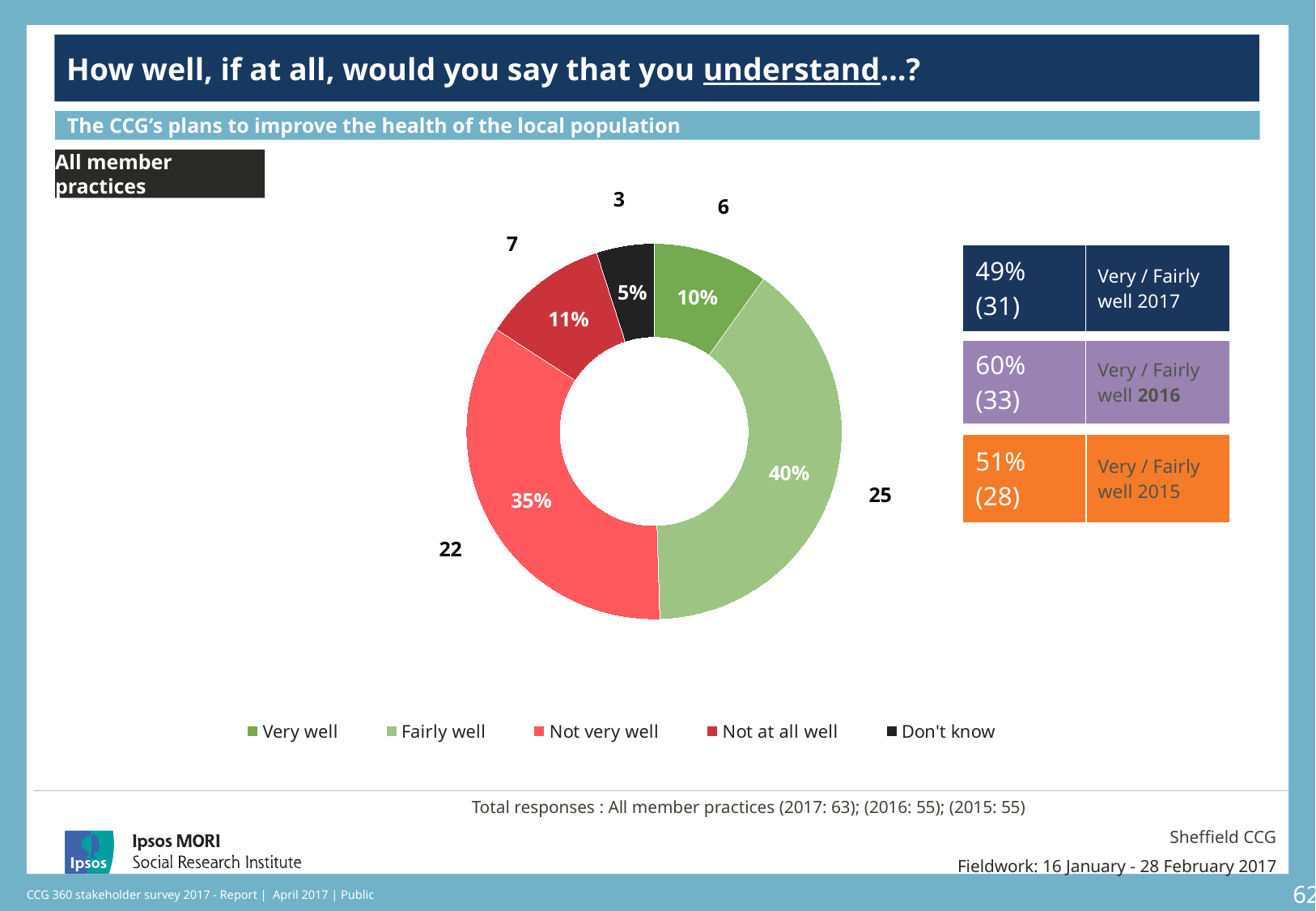
What percentage of respondents answered 'Very well'? 10% What is the difference in percentage points between 'Fairly well' and 'Not very well'? 5 percentage points How many response categories does the legend list? 5 Which response category has the largest share of the pie? Fairly well What percentage of respondents answered 'Not very well'? 35% What percentage of respondents answered 'Don't know'? 5% Which is larger, the share for 'Not at all well' or the share for 'Very well'? Not at all well What percentage of respondents said they understand the CCG's plans 'Fairly well'? 40% What colour is used for the 'Not very well' slice? Red (light red/coral) What kind of chart is shown on the slide? Pie chart (donut) Which response category has the smallest share of the pie? Don't know How many respondents answered 'Not at all well'? 7